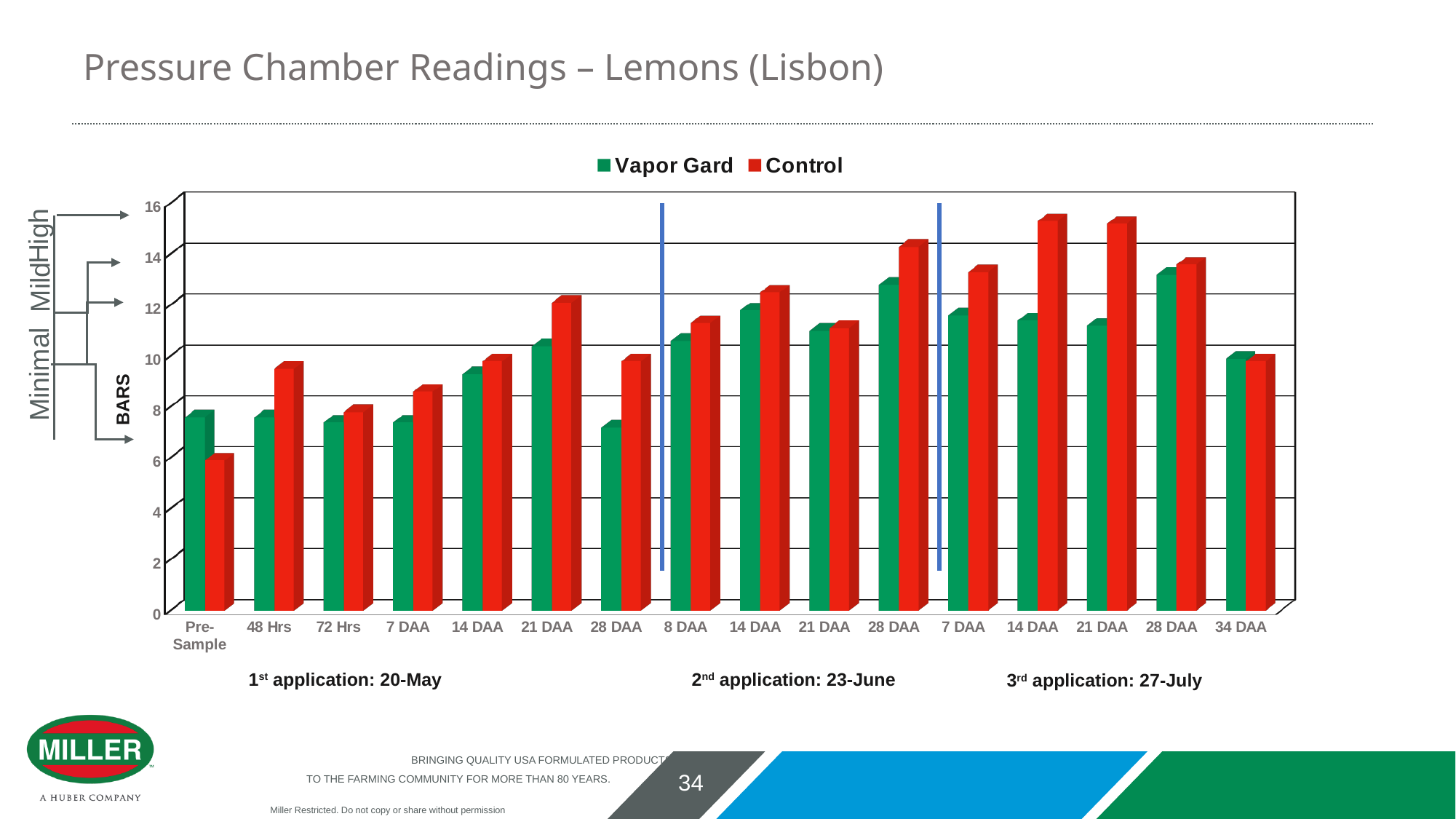
Is the Control value for 48 Hrs greater or less than 8? greater Is the Vapor Gard value for 34 DAA greater or less than 12? less What kind of chart is shown on the slide? bar chart What is the label on the y axis? BARS For Pre-Sample, which is larger, Vapor Gard or Control? Vapor Gard How many series does the legend list? 2 How many categories are shown along the x axis? 16 For 21 DAA after the 1st application, which is larger, Vapor Gard or Control? Control Which category has the lowest Control value? Pre-Sample What colour represents the Control series? red Is the Control value for Pre-Sample greater or less than 8? less